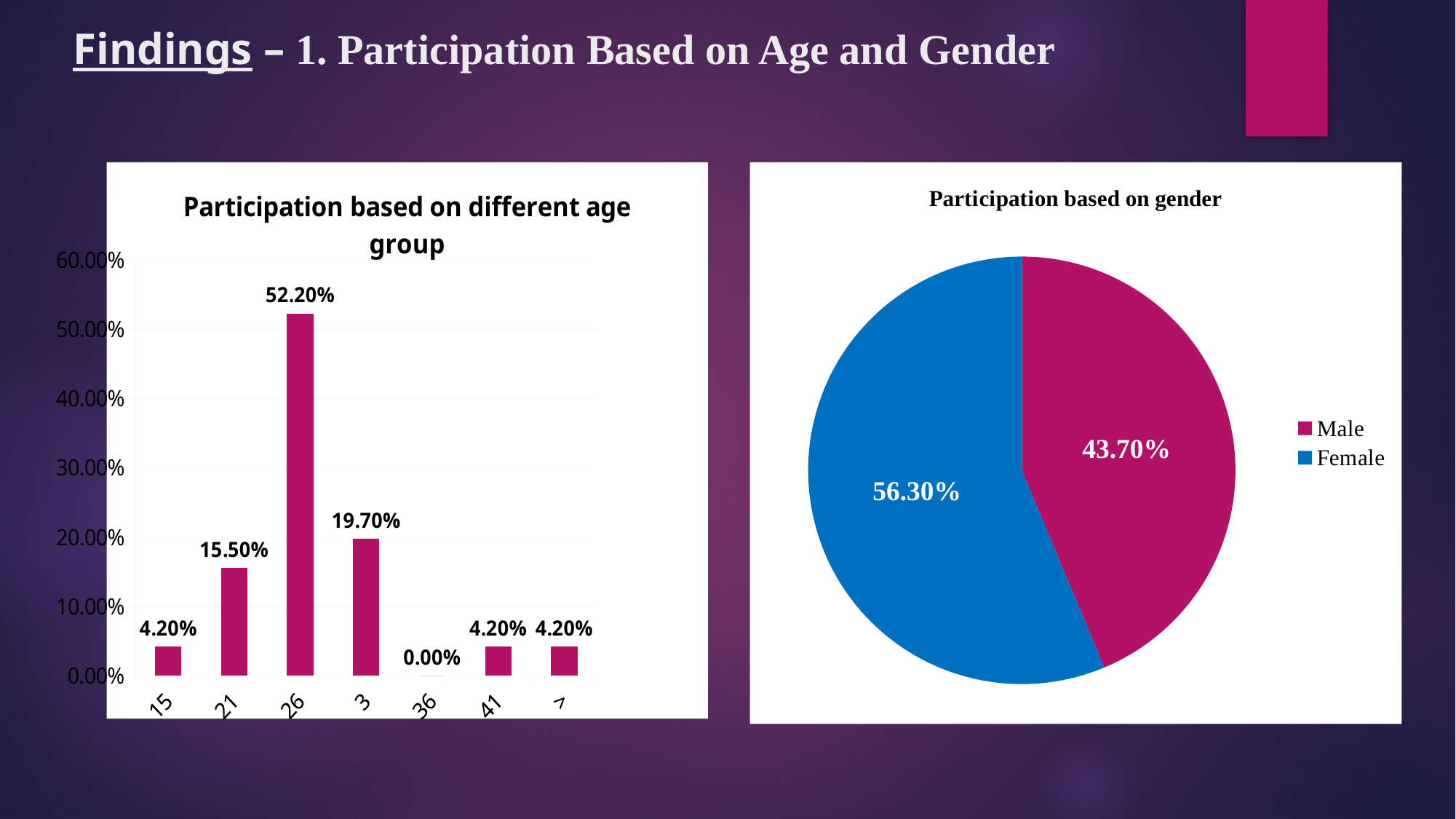
In the left chart "Participation based on different age group", is the value of the third bar (labelled 26) greater or less than 50.00%? greater In the right chart "Participation based on gender", what share of the pie is Male? 43.70% In the left chart "Participation based on different age group", how many bars are plotted? 7 In the left chart "Participation based on different age group", what is the value of the highest bar? 52.20% In the right chart "Participation based on gender", which is larger, Male or Female? Female In the left chart "Participation based on different age group", what is the value of the second bar from the left (labelled 21)? 15.50% What kind of chart is the left chart titled "Participation based on different age group"? bar chart In the left chart "Participation based on different age group", what is the value of the lowest bar (labelled 36)? 0.00% In the left chart "Participation based on different age group", what is the difference between the third bar (52.20%) and the fourth bar (19.70%)? 32.50% What kind of chart is the right chart titled "Participation based on gender"? pie chart In the right chart "Participation based on gender", how many entries does the legend list? 2 In the left chart "Participation based on different age group", what is the value of the fourth bar from the left? 19.70%